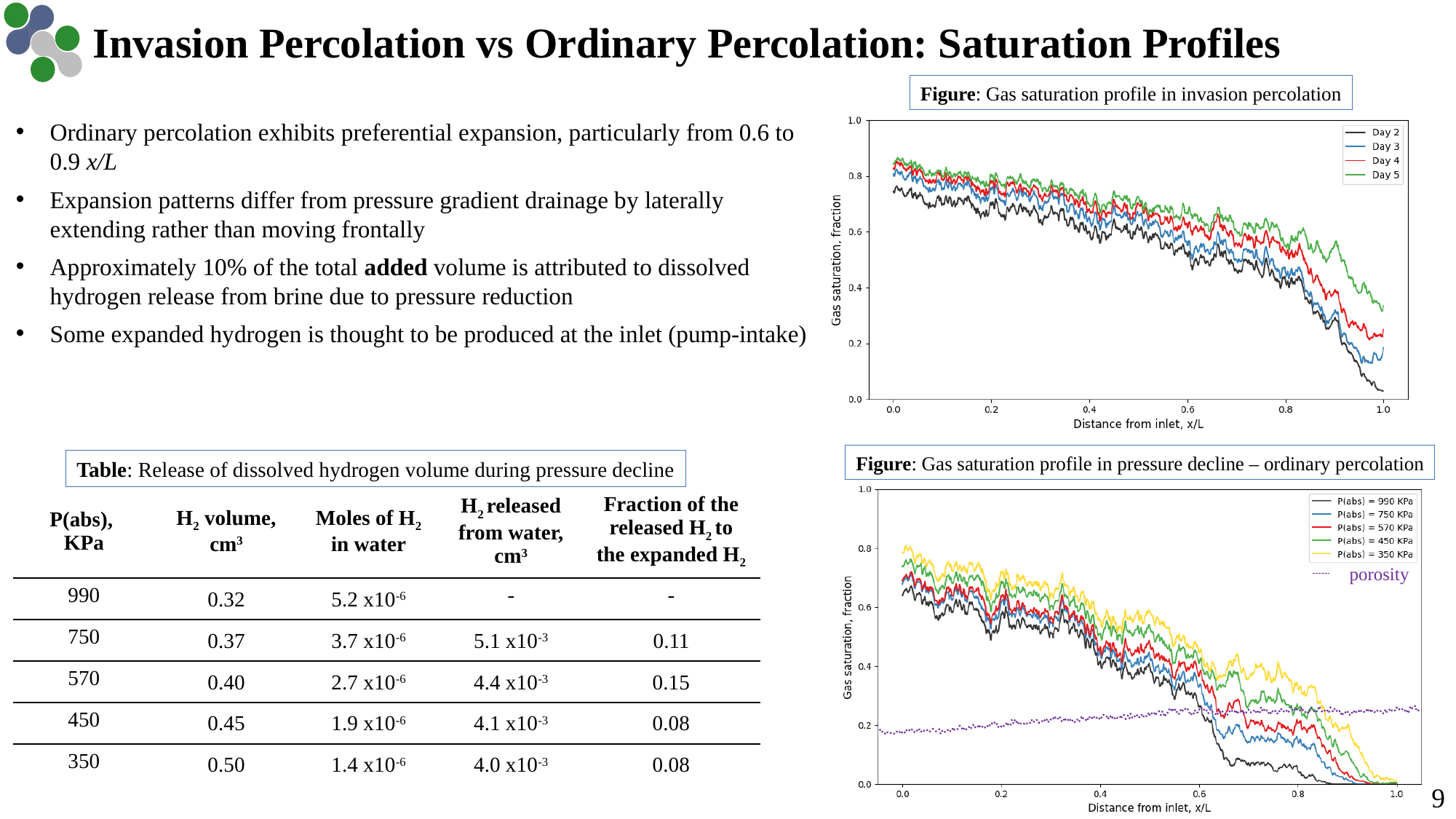
In the figure 'Gas saturation profile in invasion percolation', do the gas saturation values rise or fall as distance from inlet increases? fall In the figure 'Gas saturation profile in invasion percolation', is the Day 5 gas saturation at x/L = 1.0 greater or less than 0.2? greater In the figure 'Gas saturation profile in pressure decline – ordinary percolation', is the gas saturation for P(abs) = 990 KPa at x/L = 0.8 greater or less than 0.2? less What kind of chart is the figure titled 'Gas saturation profile in invasion percolation'? line chart In the figure 'Gas saturation profile in invasion percolation', which series has the highest gas saturation at x/L = 1.0? Day 5 In the figure 'Gas saturation profile in invasion percolation', how many series does the legend list? 4 In the figure 'Gas saturation profile in pressure decline – ordinary percolation', what is the label of the y axis? Gas saturation, fraction In the figure 'Gas saturation profile in pressure decline – ordinary percolation', at x/L = 0.7, which has the higher gas saturation: P(abs) = 350 KPa or P(abs) = 990 KPa? P(abs) = 350 KPa In the figure 'Gas saturation profile in pressure decline – ordinary percolation', how many P(abs) series does the legend list? 5 In the figure 'Gas saturation profile in invasion percolation', what are the legend entries? Day 2, Day 3, Day 4, Day 5 In the figure 'Gas saturation profile in pressure decline – ordinary percolation', do the P(abs) gas saturation curves rise or fall as distance from inlet increases? fall In the figure 'Gas saturation profile in invasion percolation', which series has the lowest gas saturation at x/L = 1.0? Day 2